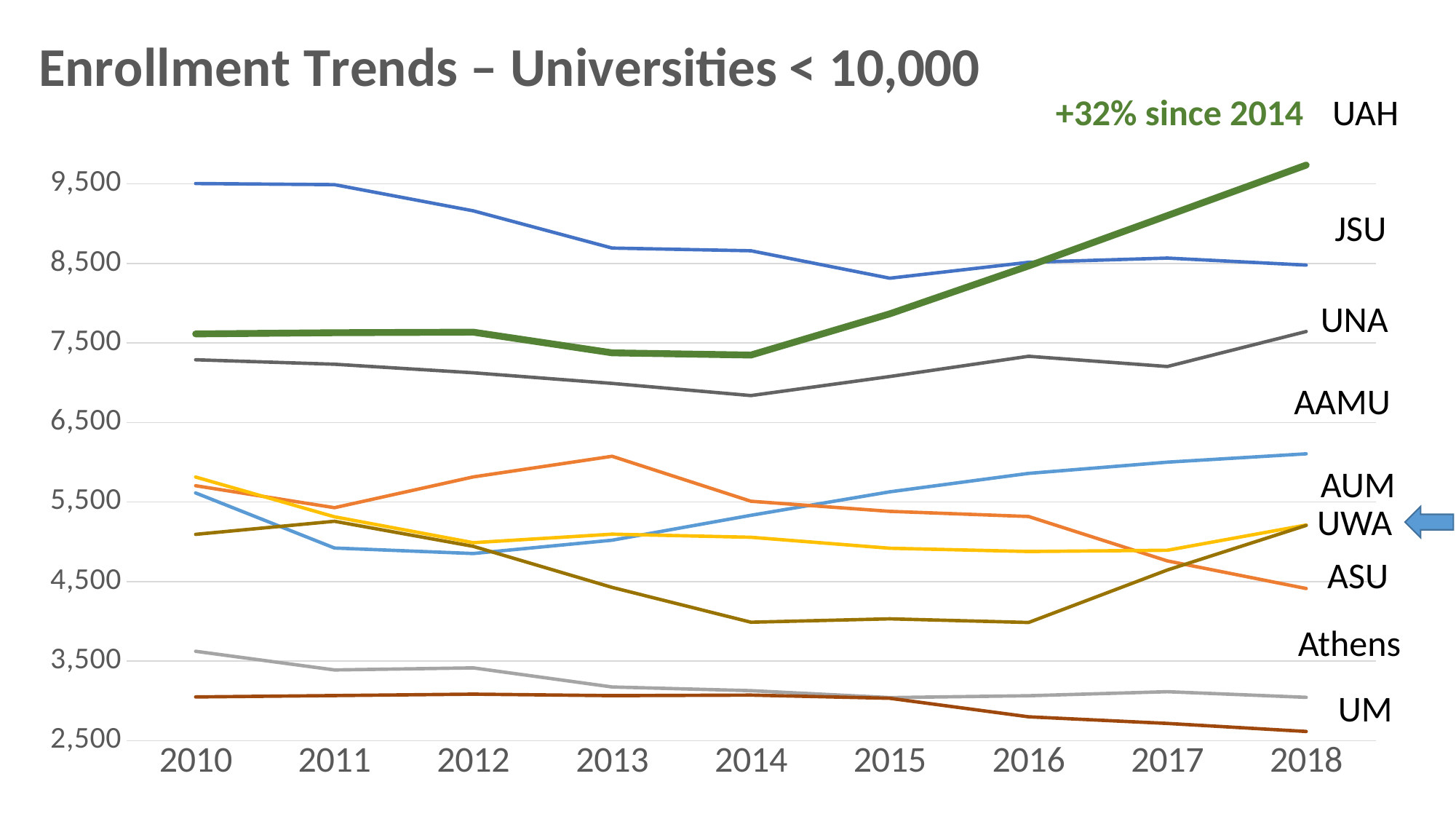
Which university has the highest enrollment in 2010? JSU How many years are plotted along the x axis? 9 Is the value for UAH in 2018 greater or less than 8,500? greater Does the UM line rise or fall from 2014 to 2018? fall Which university has the lowest enrollment in 2018? UM In 2014, which is larger: the enrollment for JSU or for UAH? JSU Which university does the annotation "+32% since 2014" refer to? UAH Which university has the highest enrollment in 2018? UAH Does the UAH line rise or fall from 2014 to 2018? rise What kind of chart is shown on the slide? line chart Is the value for AAMU in 2014 greater or less than 4,500? greater How many universities (lines) are labelled on the chart? 9